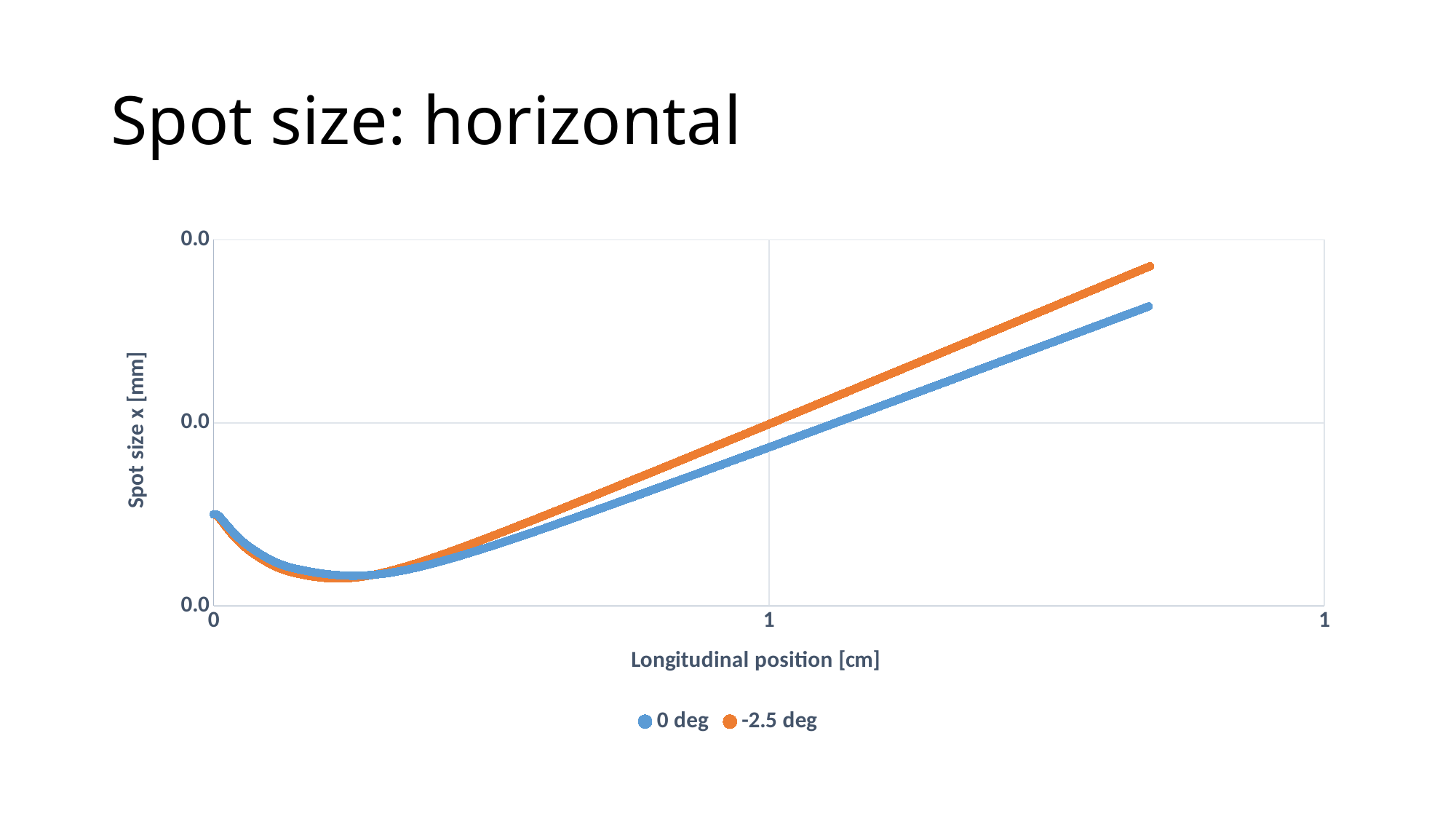
What is the title of the slide? Spot size: horizontal How many series does the legend list? 2 What are the names of the two series in the legend? 0 deg and -2.5 deg Which series is drawn in orange? -2.5 deg What is the label of the x axis? Longitudinal position [cm] Do the spot size values rise or fall along the x axis after the minimum near the left of the chart? Rise Do the spot size values rise or fall at the very start of the x axis, before the minimum? Fall Which series reaches the higher value at the far right of the chart, 0 deg or -2.5 deg? -2.5 deg What is the label of the y axis? Spot size x [mm] Which series has the larger spot size at the right end of the plotted range? -2.5 deg What kind of chart is shown on the slide? Scatter chart